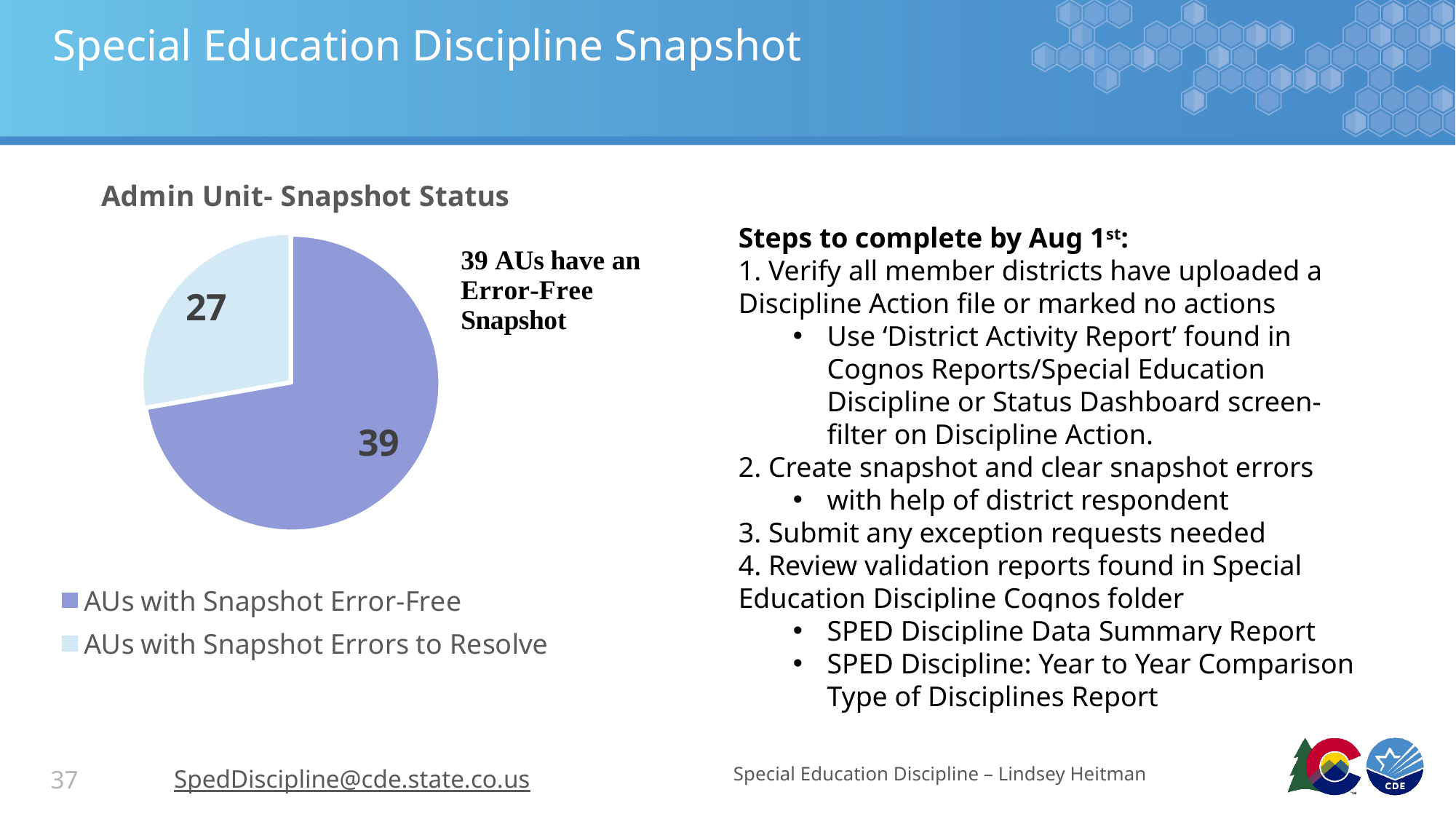
Which category has the larger slice of the pie? AUs with Snapshot Error-Free Is the value for AUs with Snapshot Error-Free larger or smaller than the value for AUs with Snapshot Errors to Resolve? larger How many AUs have a Snapshot Error-Free? 39 How many slices does the pie chart have? 2 How many AUs have Snapshot Errors to Resolve? 27 How many entries does the legend list? 2 Which category has the smaller slice of the pie? AUs with Snapshot Errors to Resolve What type of chart is shown on the slide? pie chart What is the total number of AUs represented in the pie chart? 66 What is the title of the chart? Admin Unit- Snapshot Status What is the difference between the number of AUs with Snapshot Error-Free and the number with Snapshot Errors to Resolve? 12 Which legend entry is shown in light blue? AUs with Snapshot Errors to Resolve